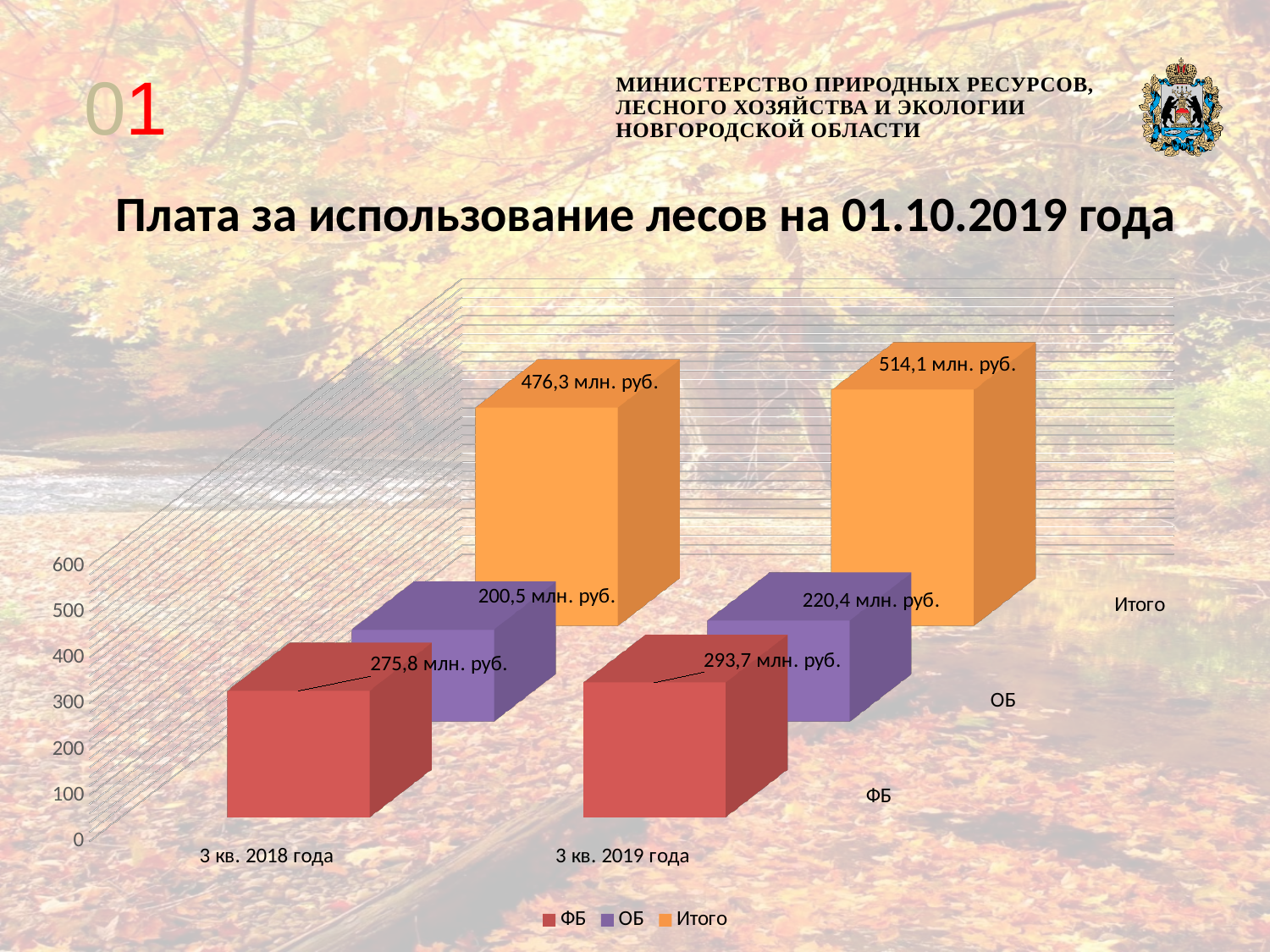
Which series has the lowest value in 3 кв. 2018 года? ОБ Which series has the highest value in 3 кв. 2019 года? Итого Which is larger: ФБ in 3 кв. 2018 года or ФБ in 3 кв. 2019 года? ФБ in 3 кв. 2019 года Is the value for Итого in 3 кв. 2019 года greater or less than 500? greater How many series does the legend list? 3 What is the title of the chart on the slide? Плата за использование лесов на 01.10.2019 года What is the value for Итого in 3 кв. 2018 года? 476,3 млн. руб. What is the difference between the Итого values for 3 кв. 2019 года and 3 кв. 2018 года? 37,8 млн. руб. What is the value for ФБ in 3 кв. 2018 года? 275,8 млн. руб. What is the value for Итого in 3 кв. 2019 года? 514,1 млн. руб. What kind of chart is shown on the slide? Bar chart What is the value for ОБ in 3 кв. 2019 года? 220,4 млн. руб.